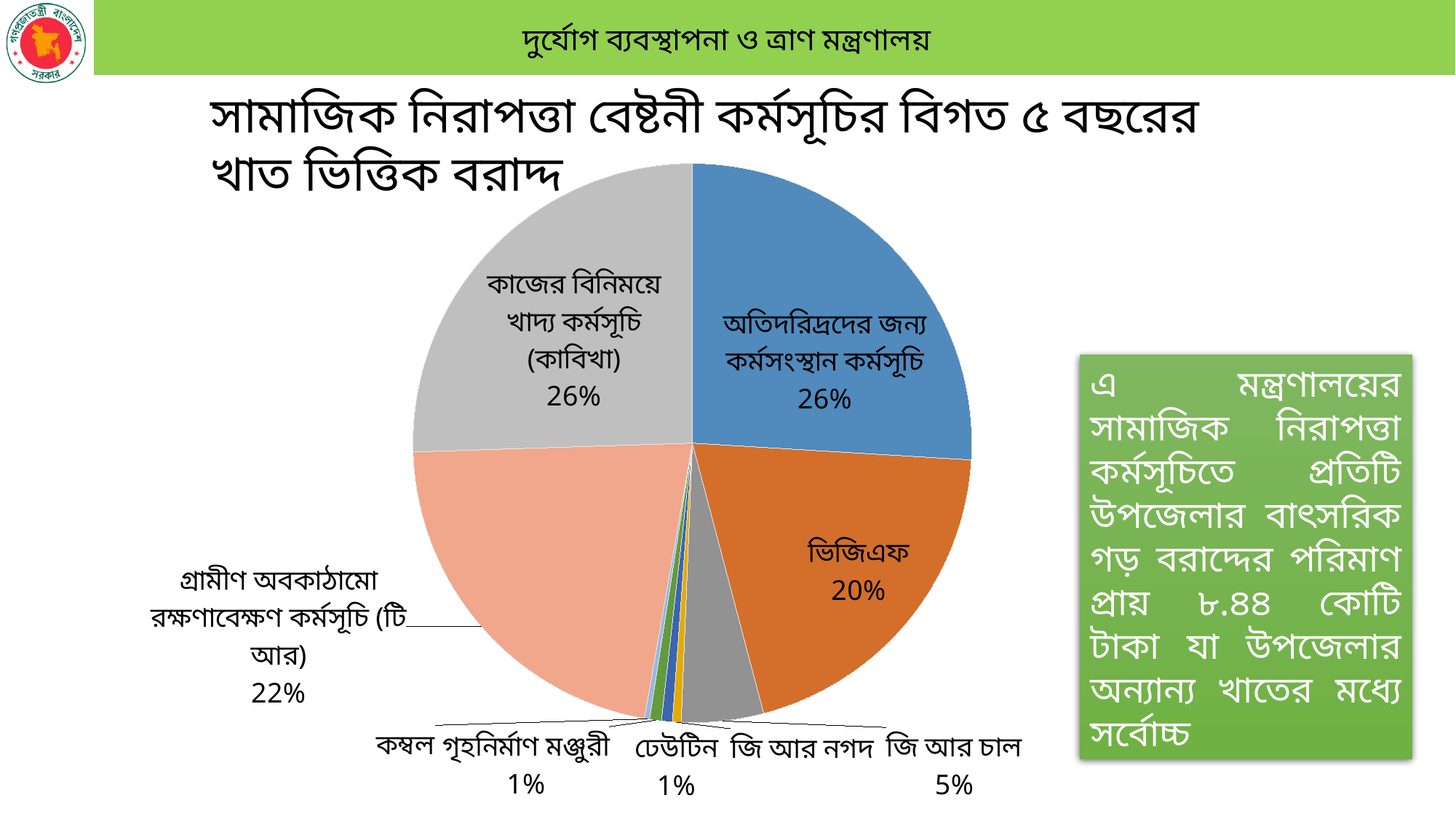
What kind of chart is shown on the slide? pie chart How many categories are labelled on the pie chart? 9 What percentage is shown for জি আর চাল? 5% Which is larger, the share for ভিজিএফ or the share for গ্রামীণ অবকাঠামো রক্ষণাবেক্ষণ কর্মসূচি (টি আর)? গ্রামীণ অবকাঠামো রক্ষণাবেক্ষণ কর্মসূচি (টি আর) What percentage is shown for গ্রামীণ অবকাঠামো রক্ষণাবেক্ষণ কর্মসূচি (টি আর)? 22% What is the title of the chart on the slide? সামাজিক নিরাপত্তা বেষ্টনী কর্মসূচির বিগত ৫ বছরের খাত ভিত্তিক বরাদ্দ What is the difference in percentage points between গ্রামীণ অবকাঠামো রক্ষণাবেক্ষণ কর্মসূচি (টি আর) and জি আর চাল? 17 percentage points What is the difference in percentage points between কাজের বিনিময়ে খাদ্য কর্মসূচি (কাবিখা) and ভিজিএফ? 6 percentage points Which is larger, the share for জি আর চাল or the share for ভিজিএফ? ভিজিএফ What percentage is shown for অতিদরিদ্রদের জন্য কর্মসংস্থান কর্মসূচি? 26% What percentage is shown for কাজের বিনিময়ে খাদ্য কর্মসূচি (কাবিখা)? 26% What share of the pie does ভিজিএফ account for? 20%